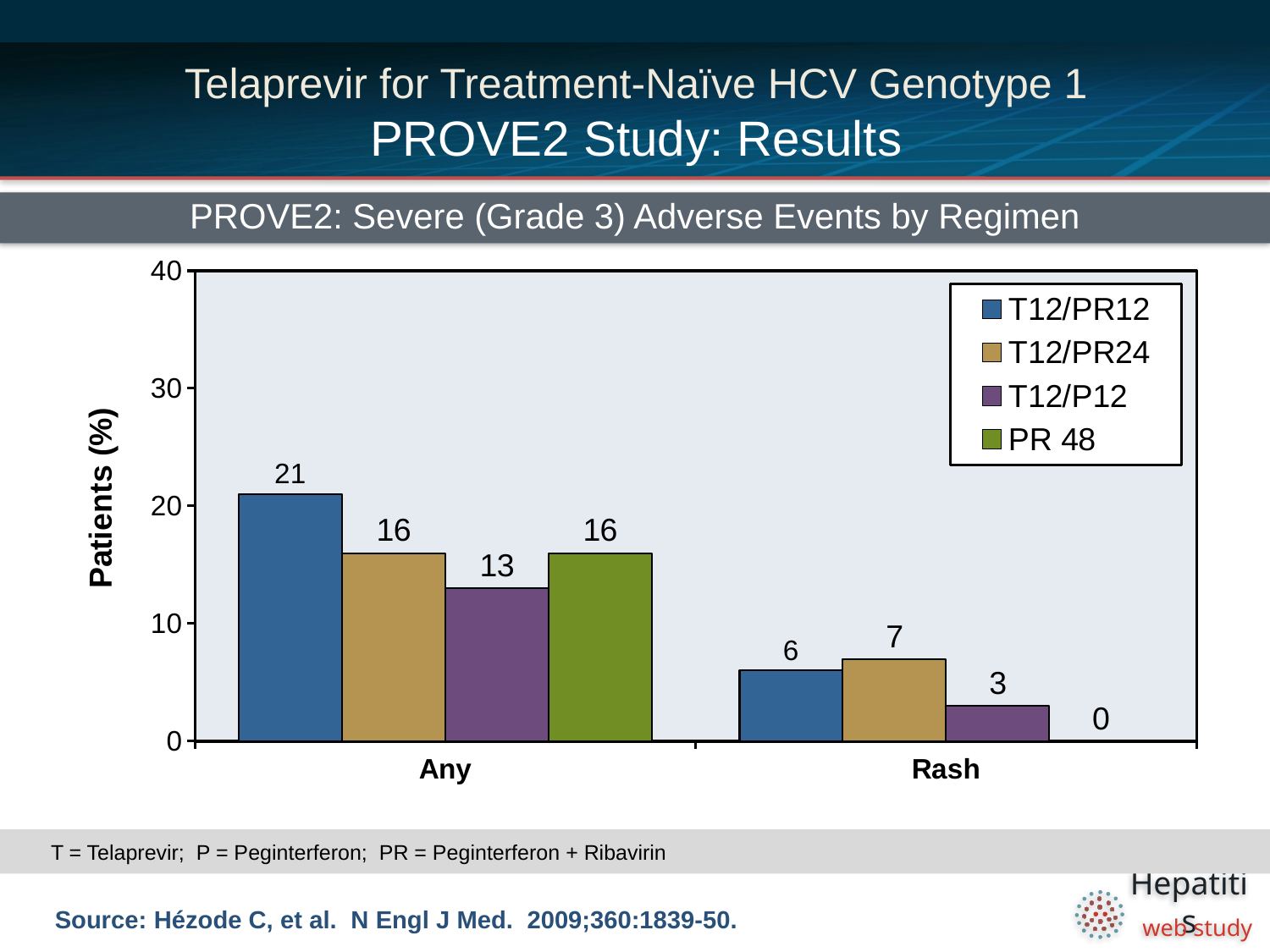
How many categories are shown on the x axis? 2 Which is larger in the Rash category, T12/PR12 or T12/PR24? T12/PR24 What is the value for T12/P12 in the Rash category? 3 What is the value for T12/PR12 in the Any category? 21 Which regimen has the highest value in the Any category? T12/PR12 What is the value for PR 48 in the Rash category? 0 What is the difference between T12/PR12 and T12/P12 in the Any category? 8 Which regimen has the lowest value in the Rash category? PR 48 What kind of chart is shown on the slide? bar chart How many series does the legend list? 4 Is the value for T12/PR24 in the Any category greater or less than 20? less What is the label of the y axis? Patients (%)